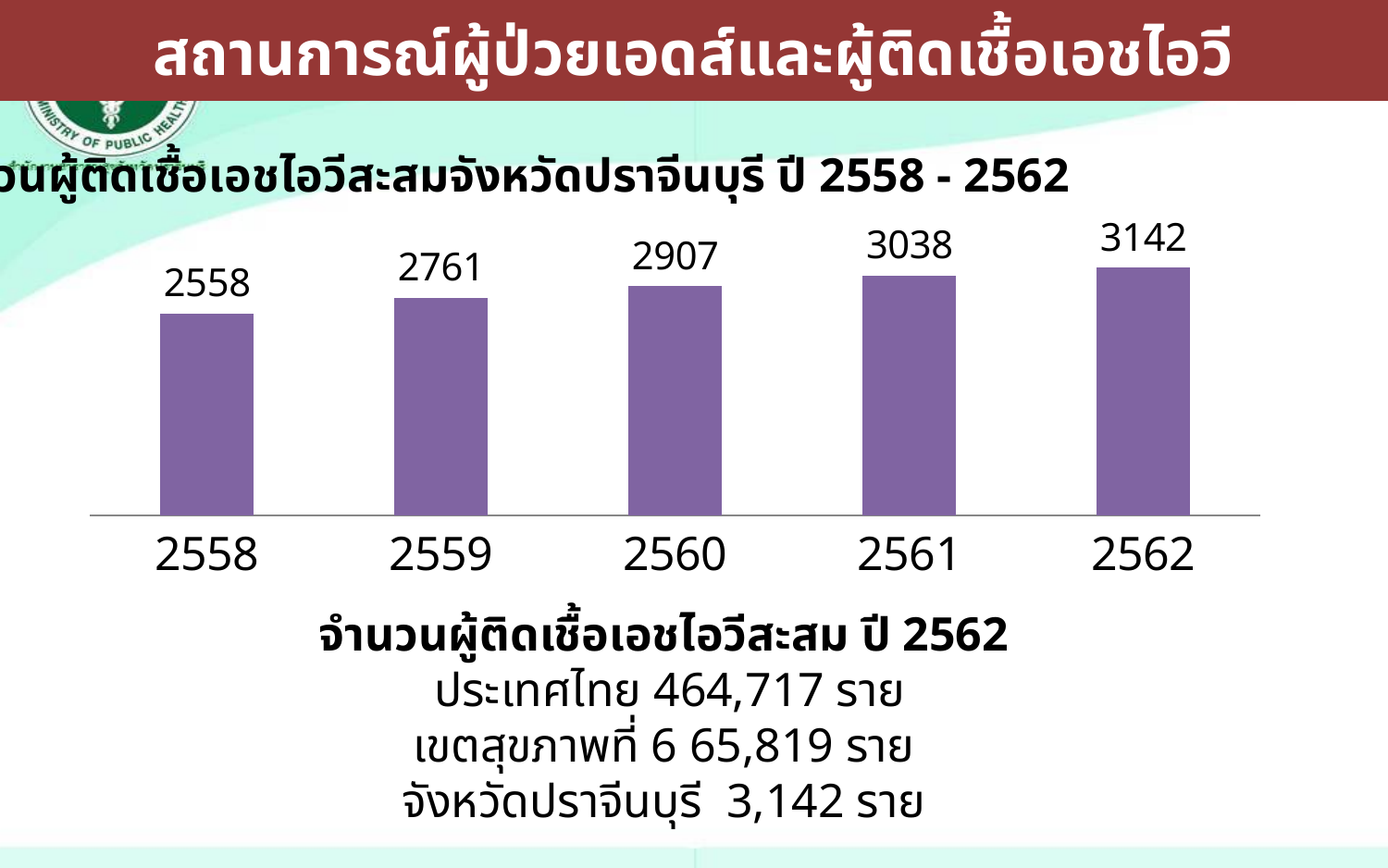
What is the value for the year 2558? 2558 What is the value for the year 2559? 2761 What is the value for the year 2560? 2907 What is the value for the year 2561? 3038 What is the value for the year 2562? 3142 What is the difference between the values for 2561 and 2560? 131 Which year has the highest value? 2562 How many years are shown on the x axis? 5 Which is larger, the value for 2559 or the value for 2560? 2560 Which year has the lowest value? 2558 What is the difference between the values for 2562 and 2558? 584 What kind of chart is shown? bar chart